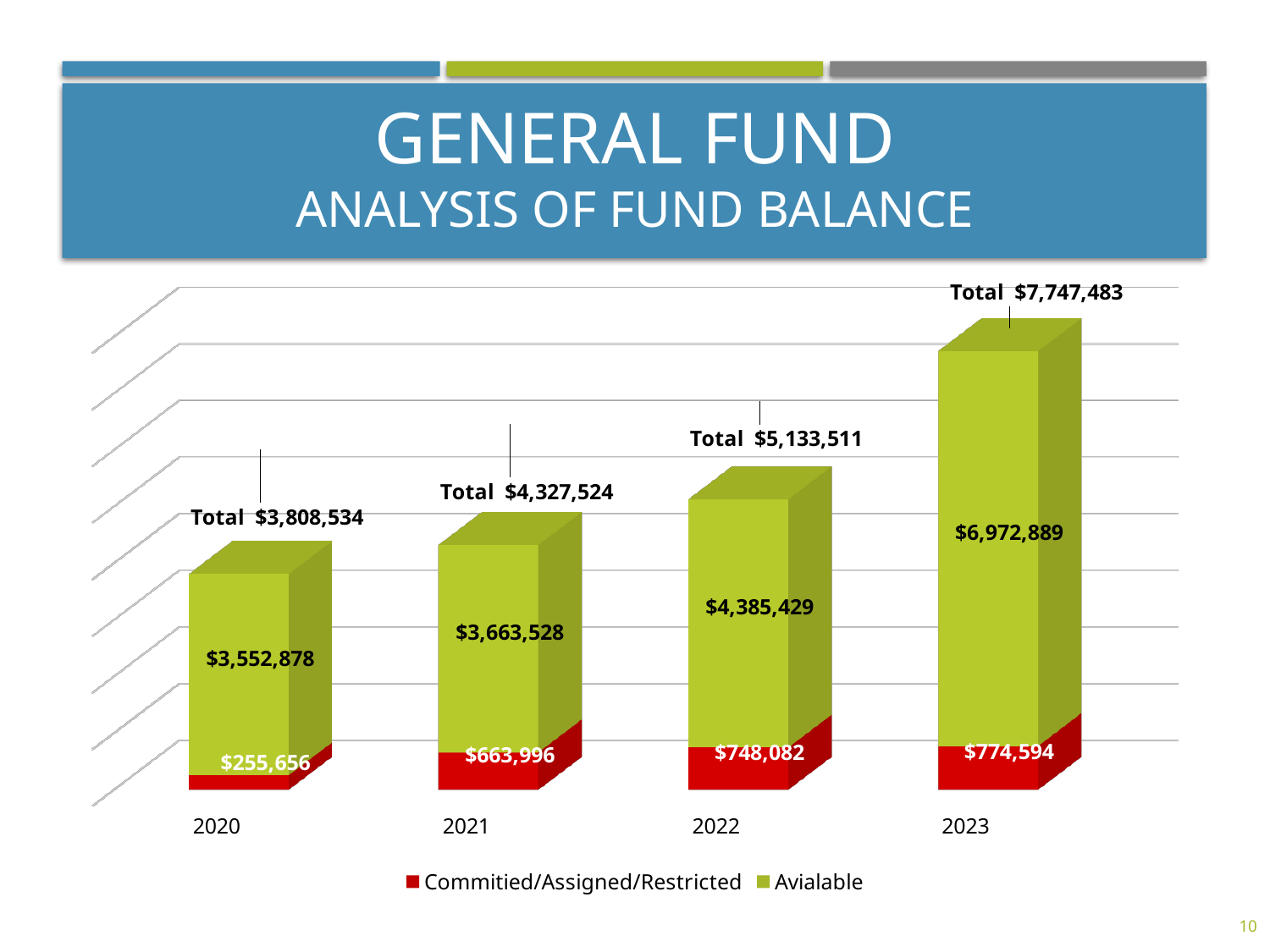
What is the Committed/Assigned/Restricted value for 2020? $255,656 How many years are shown on the x axis? 4 What is the total fund balance shown for 2021? $4,327,524 Do the total fund balances rise or fall from 2020 to 2023? Rise What is the difference between the Available values for 2023 and 2022? $2,587,460 Which year has the larger Available value, 2020 or 2021? 2021 What kind of chart is shown on the slide? Stacked bar chart By how much did the Committed/Assigned/Restricted value increase from 2020 to 2021? $408,340 How many series does the legend list? 2 Which year has the lowest Committed/Assigned/Restricted value? 2020 What is the Available value for 2022? $4,385,429 Which year has the highest total fund balance? 2023